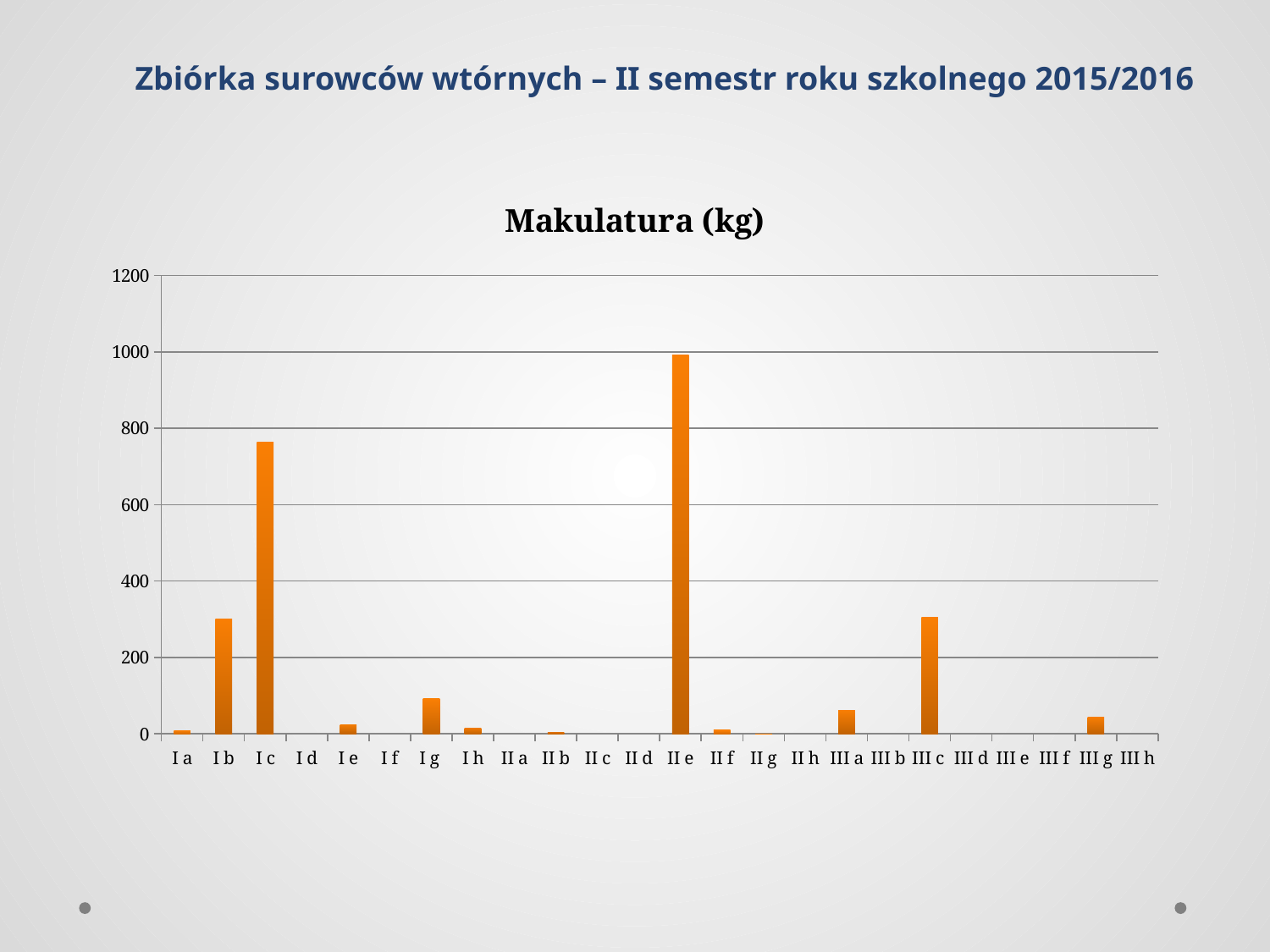
Is the value for I b greater or less than 400? less Is the value for I c greater or less than 600? greater Is the value for III c greater or less than 200? greater How many classes (categories) are shown on the x axis of the chart? 24 Which class has the highest value in the Makulatura (kg) chart? II e What kind of chart is shown on the slide? bar chart Which has a larger value, I c or II e? II e What is the title of the chart? Makulatura (kg) What is the highest value shown on the vertical axis of the chart? 1200